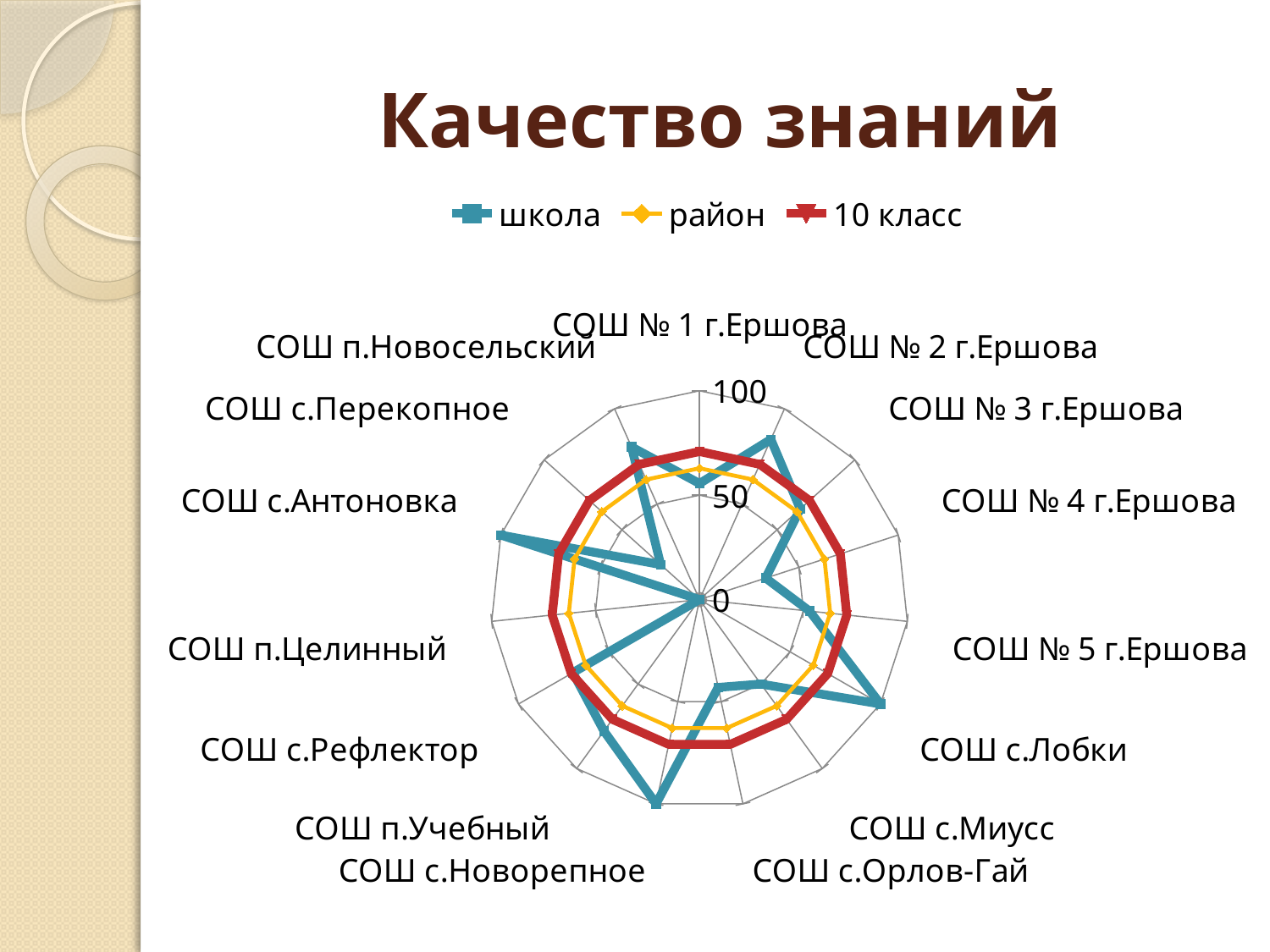
Is the школа value for СОШ п.Учебный greater or less than 50? greater For СОШ с.Лобки, which is larger: the район value or the 10 класс value? 10 класс Is the школа value for СОШ п.Целинный greater or less than 50? less For СОШ с.Антоновка, which is larger: the школа value or the район value? школа What kind of chart is shown on the slide? radar chart Is the школа value for СОШ № 2 г.Ершова greater or less than 50? greater How many series does the legend list? 3 Which series are listed in the legend? школа, район, 10 класс For СОШ № 4 г.Ершова, which is larger: the школа value or the район value? район What is the title of the chart? Качество знаний